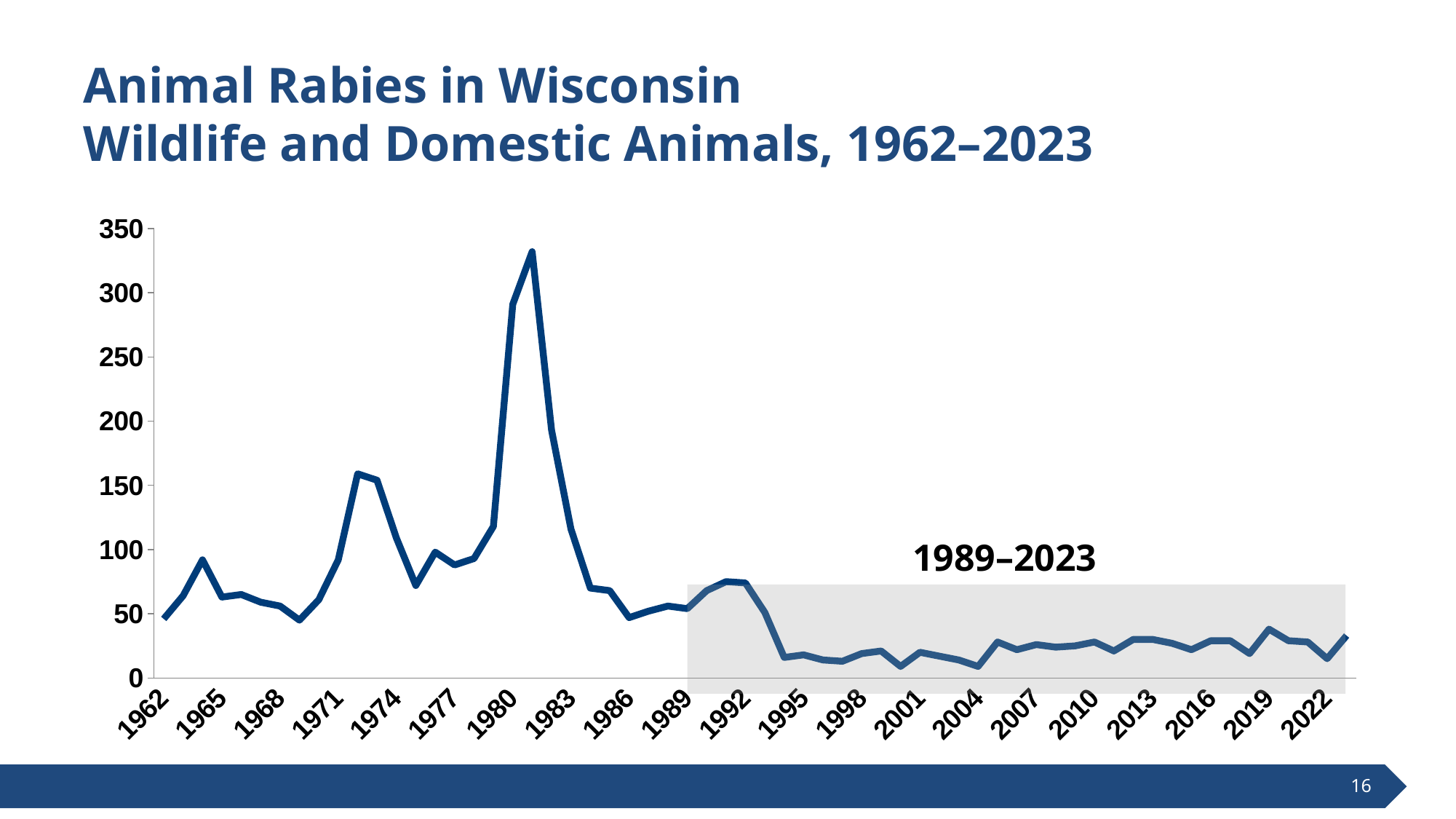
What kind of chart is shown on the slide? line chart How many year labels are shown on the x axis? 21 Is the value for 1989 greater or less than 100? less Do the values rise or fall between 1989 and 1995? fall Is the value for 1962 greater or less than 100? less What label is printed above the shaded region at the right of the chart? 1989–2023 Which year has the larger value, 1962 or 1971? 1971 Is the value for 2022 greater or less than 50? less What is the title of the slide's chart? Animal Rabies in Wisconsin Wildlife and Domestic Animals, 1962–2023 Between which two labelled years on the x axis does the highest point of the line fall? 1980 and 1983